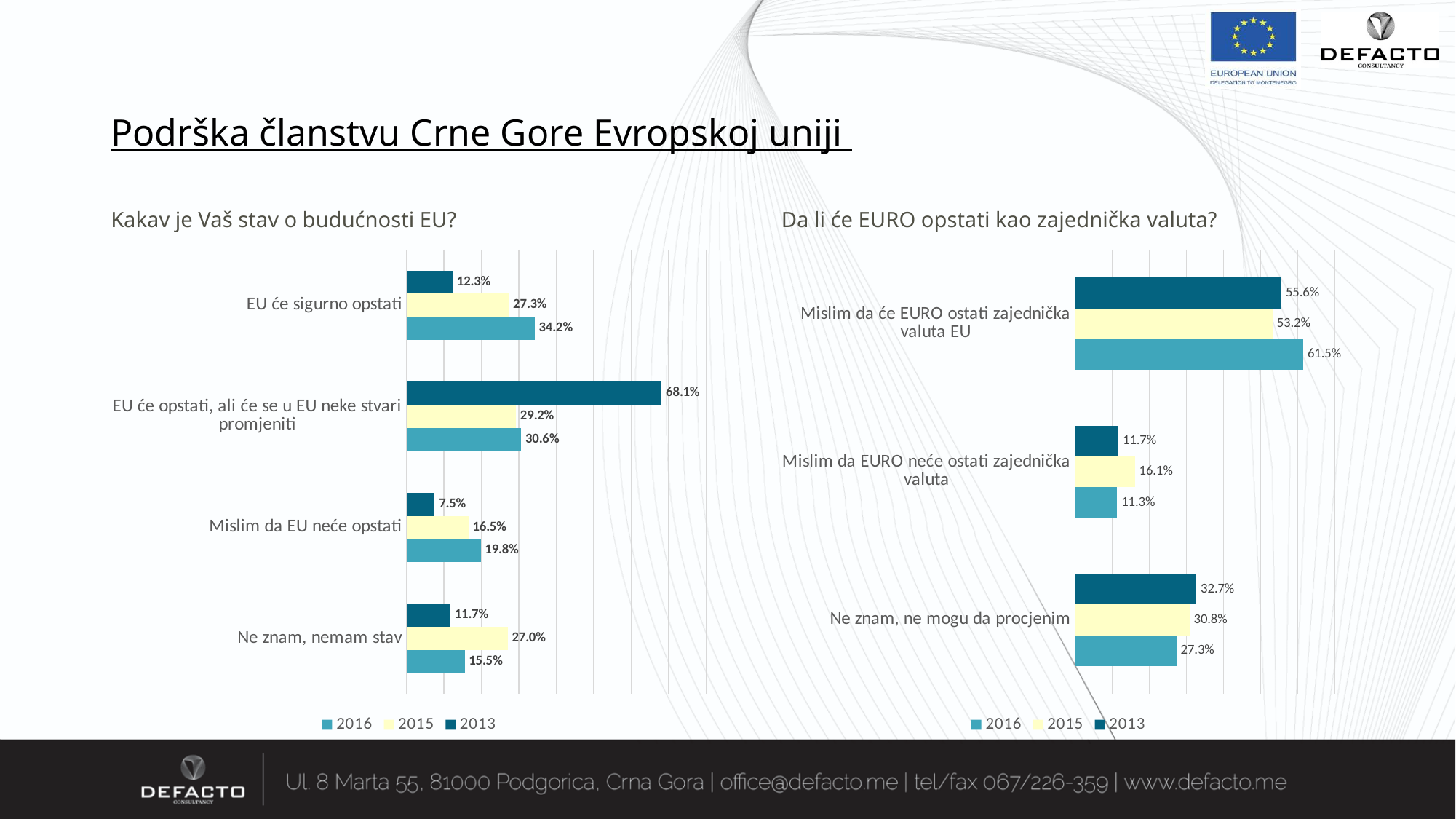
In the chart 'Da li će EURO opstati kao zajednička valuta?', what is the 2015 value for 'Ne znam, ne mogu da procjenim'? 30.8% In the chart 'Kakav je Vaš stav o budućnosti EU?', what is the 2013 value for 'EU će opstati, ali će se u EU neke stvari promjeniti'? 68.1% What type of chart is 'Kakav je Vaš stav o budućnosti EU?'? Bar chart In the chart 'Da li će EURO opstati kao zajednička valuta?', what is the 2016 value for 'Mislim da će EURO ostati zajednička valuta EU'? 61.5% In the chart 'Kakav je Vaš stav o budućnosti EU?', which category has the lowest 2016 value? Ne znam, nemam stav In the chart 'Kakav je Vaš stav o budućnosti EU?', what is the 2016 value for 'EU će sigurno opstati'? 34.2% In the chart 'Da li će EURO opstati kao zajednička valuta?', which is larger for 'Mislim da EURO neće ostati zajednička valuta': the 2015 value or the 2016 value? 2015 How many series does the legend of the chart 'Da li će EURO opstati kao zajednička valuta?' list? 3 In the chart 'Kakav je Vaš stav o budućnosti EU?', what is the difference between the 2015 and 2013 values for 'Mislim da EU neće opstati'? 9.0% In the chart 'Kakav je Vaš stav o budućnosti EU?', which category has the highest 2013 value? EU će opstati, ali će se u EU neke stvari promjeniti In the chart 'Da li će EURO opstati kao zajednička valuta?', what is the difference between the 2016 and 2015 values for 'Mislim da će EURO ostati zajednička valuta EU'? 8.3% In the chart 'Kakav je Vaš stav o budućnosti EU?', how many categories are shown? 4